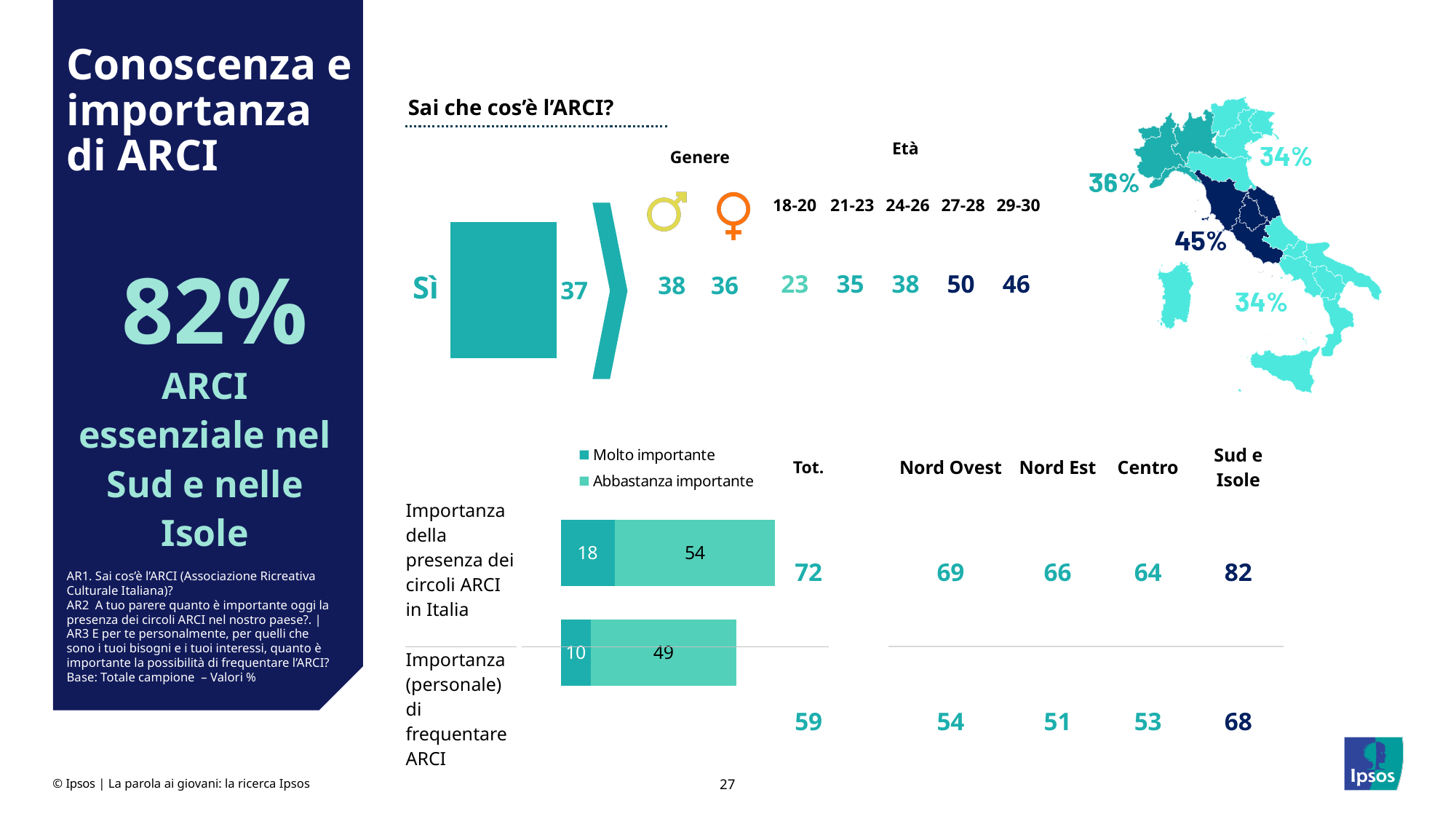
In the 'Sai che cos'è l'ARCI?' chart, which age group has the highest value for 'Sì'? 27-28 In the stacked bar chart at the bottom of the slide, what is the total of the bar for 'Importanza (personale) di frequentare ARCI'? 59 In the stacked bar chart at the bottom of the slide, how many categories (bars) are shown? 2 In the stacked bar chart at the bottom of the slide, what is the 'Abbastanza importante' value for 'Importanza (personale) di frequentare ARCI'? 49 In the stacked bar chart at the bottom of the slide, which category has the higher 'Molto importante' value? Importanza della presenza dei circoli ARCI in Italia In the stacked bar chart at the bottom of the slide, what is the 'Molto importante' value for 'Importanza della presenza dei circoli ARCI in Italia'? 18 In the stacked bar chart at the bottom of the slide, how many series does the legend list? 2 In the 'Sai che cos'è l'ARCI?' chart, which age group has the lowest value for 'Sì'? 18-20 In the 'Sai che cos'è l'ARCI?' chart, what is the overall 'Sì' value shown next to the bar? 37 What kind of chart is shown at the bottom of the slide with the 'Molto importante' and 'Abbastanza importante' legend? Stacked bar chart In the stacked bar chart at the bottom of the slide, what is the total of the bar for 'Importanza della presenza dei circoli ARCI in Italia'? 72 In the stacked bar chart at the bottom of the slide, what is the difference between the 'Abbastanza importante' values of the two bars? 5